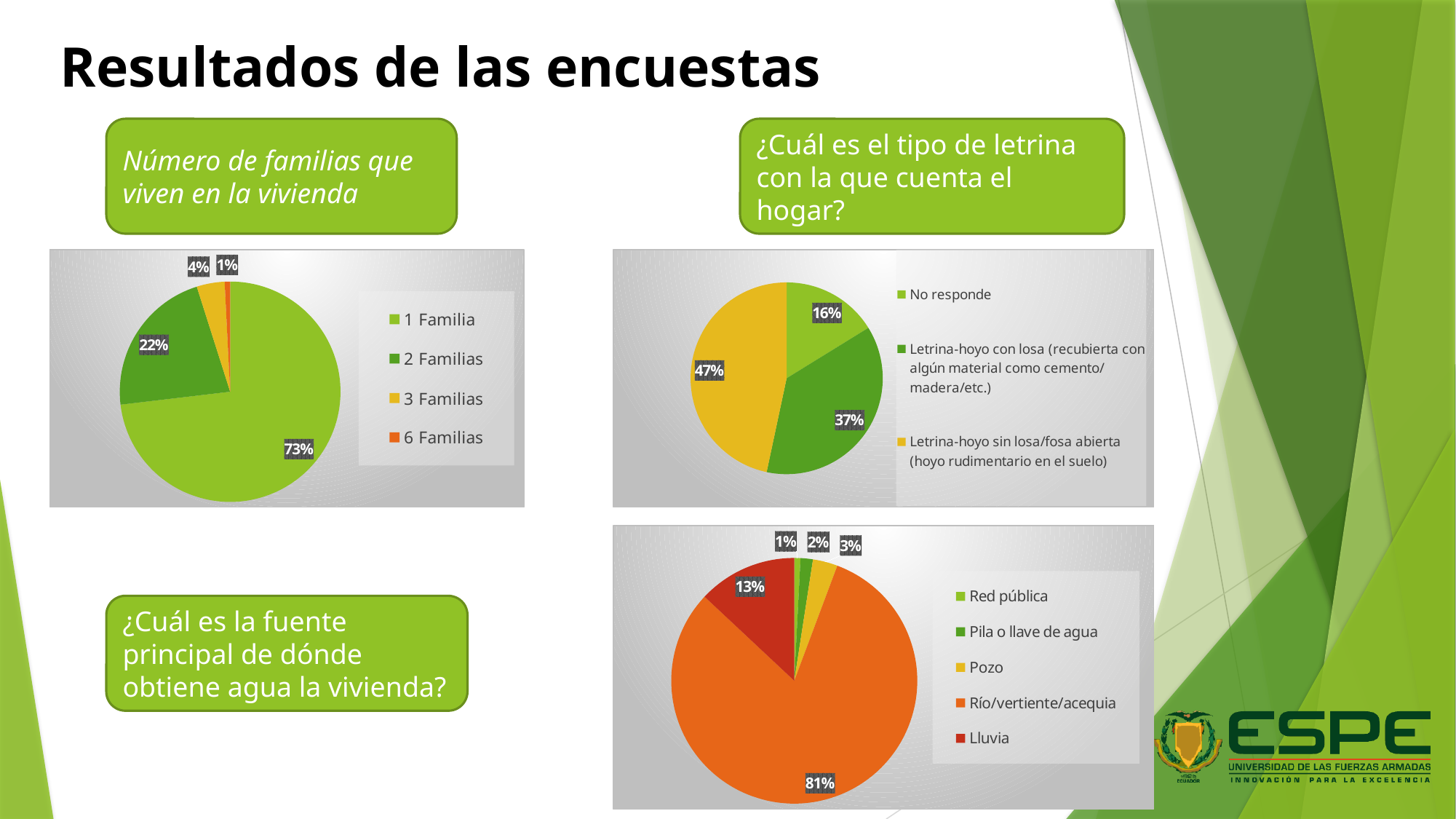
In the 'Número de familias que viven en la vivienda' chart, what percentage corresponds to 2 Familias? 22% In the '¿Cuál es el tipo de letrina con la que cuenta el hogar?' chart, which category has the largest share? Letrina-hoyo sin losa/fosa abierta (hoyo rudimentario en el suelo) In the '¿Cuál es el tipo de letrina con la que cuenta el hogar?' chart, what is the difference between the 47% slice and the 37% slice? 10% In the '¿Cuál es el tipo de letrina con la que cuenta el hogar?' chart, what percentage corresponds to 'No responde'? 16% In the '¿Cuál es la fuente principal de dónde obtiene agua la vivienda?' chart, what percentage corresponds to Río/vertiente/acequia? 81% In the 'Número de familias que viven en la vivienda' chart, how many categories does the legend list? 4 In the '¿Cuál es la fuente principal de dónde obtiene agua la vivienda?' chart, what percentage corresponds to Lluvia? 13% What kind of chart is used for 'Número de familias que viven en la vivienda'? Pie chart In the 'Número de familias que viven en la vivienda' chart, which category has the smallest share? 6 Familias In the '¿Cuál es la fuente principal de dónde obtiene agua la vivienda?' chart, which is larger, Pozo or Pila o llave de agua? Pozo In the 'Número de familias que viven en la vivienda' chart, what percentage corresponds to 1 Familia? 73% In the '¿Cuál es la fuente principal de dónde obtiene agua la vivienda?' chart, how many categories does the legend list? 5